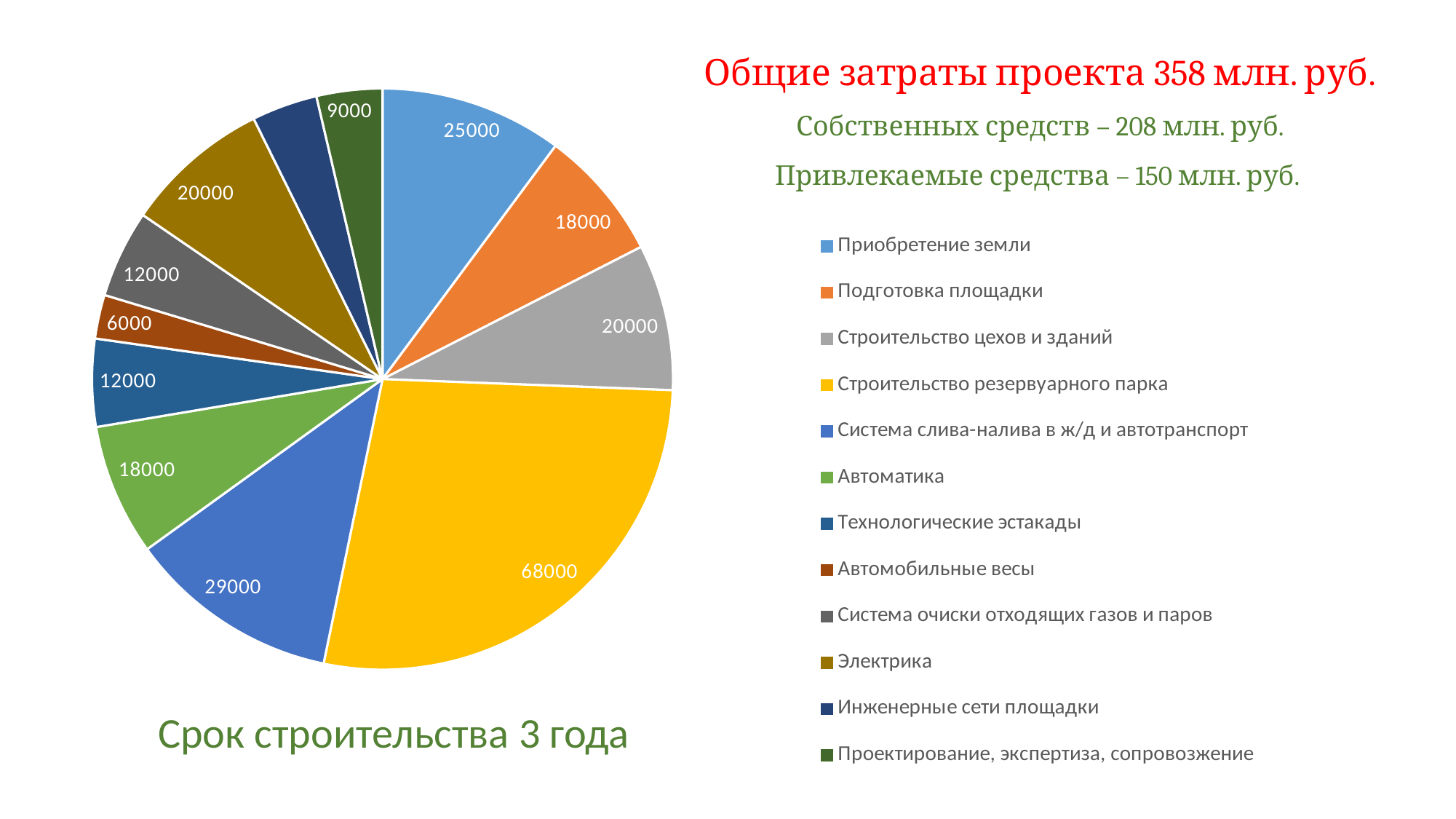
What colour is the slice for Автоматика? green How many categories does the legend of the pie chart list? 12 What is the value for Приобретение земли? 25000 What is the difference between the values for Строительство резервуарного парка and Система слива-налива в ж/д и автотранспорт? 39000 What is the value for Строительство резервуарного парка? 68000 Which category has the smallest slice of the pie? Автомобильные весы What kind of chart is shown on the slide? pie chart Which category has the largest slice of the pie? Строительство резервуарного парка What is the value for Система слива-налива в ж/д и автотранспорт? 29000 What is the value for Электрика? 20000 What is the value for Автомобильные весы? 6000 Which is larger: Подготовка площадки or Строительство цехов и зданий? Строительство цехов и зданий